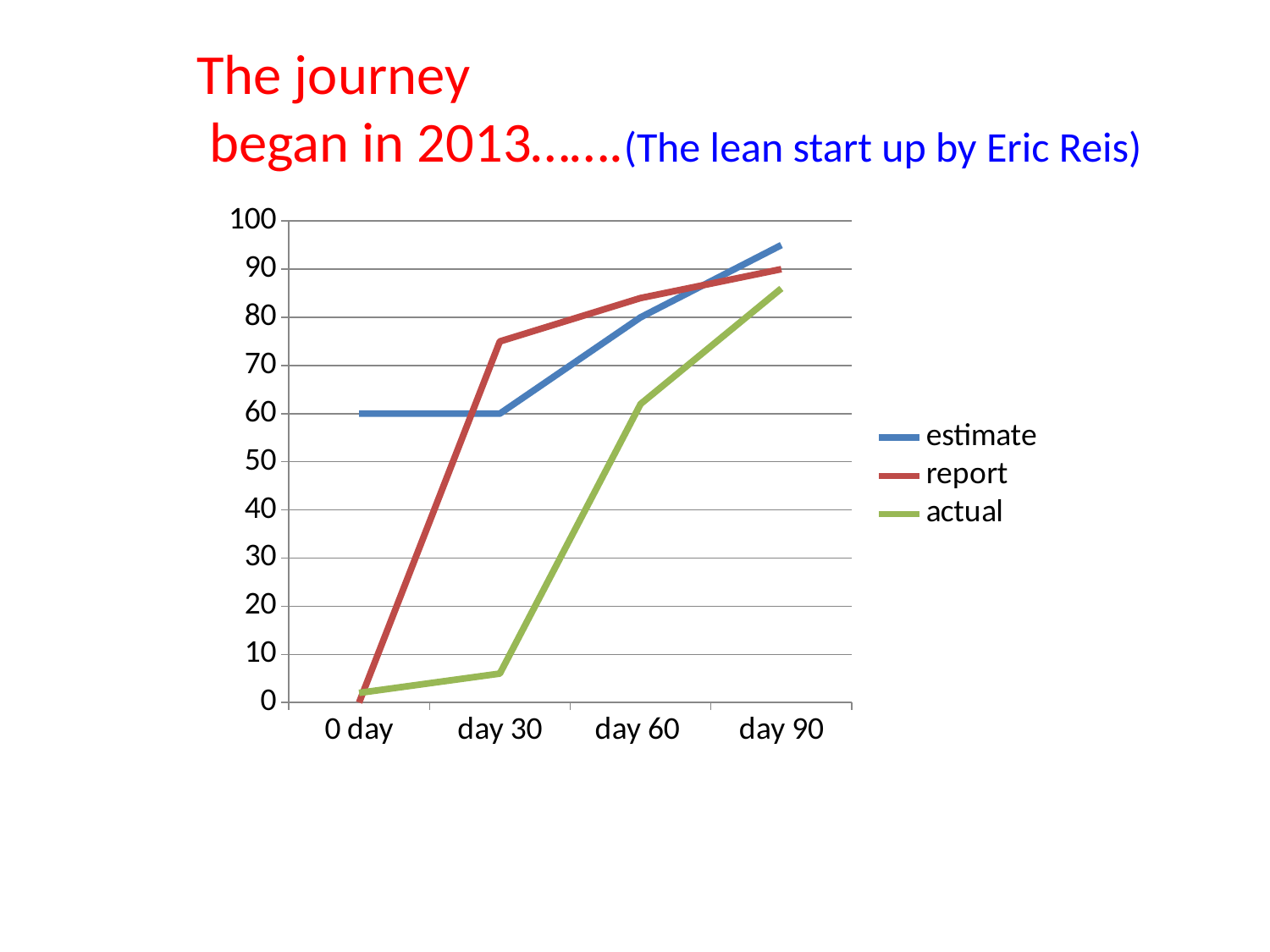
At day 30, which is larger: the report value or the estimate value? report Is the value for actual at day 30 greater or less than 10? less How many series does the legend list? 3 Which series has the highest value at day 90? estimate What is the value of the report series at 0 day? 0 What is the value of the report series at day 90? 90 Which series has the lowest value at day 30? actual How many points are plotted along the x axis for each series? 4 Does the actual series rise or fall from 0 day to day 90? rise Is the value for actual at day 60 greater or less than 50? greater What is the value of the estimate series at 0 day? 60 What kind of chart is shown on the slide? line chart